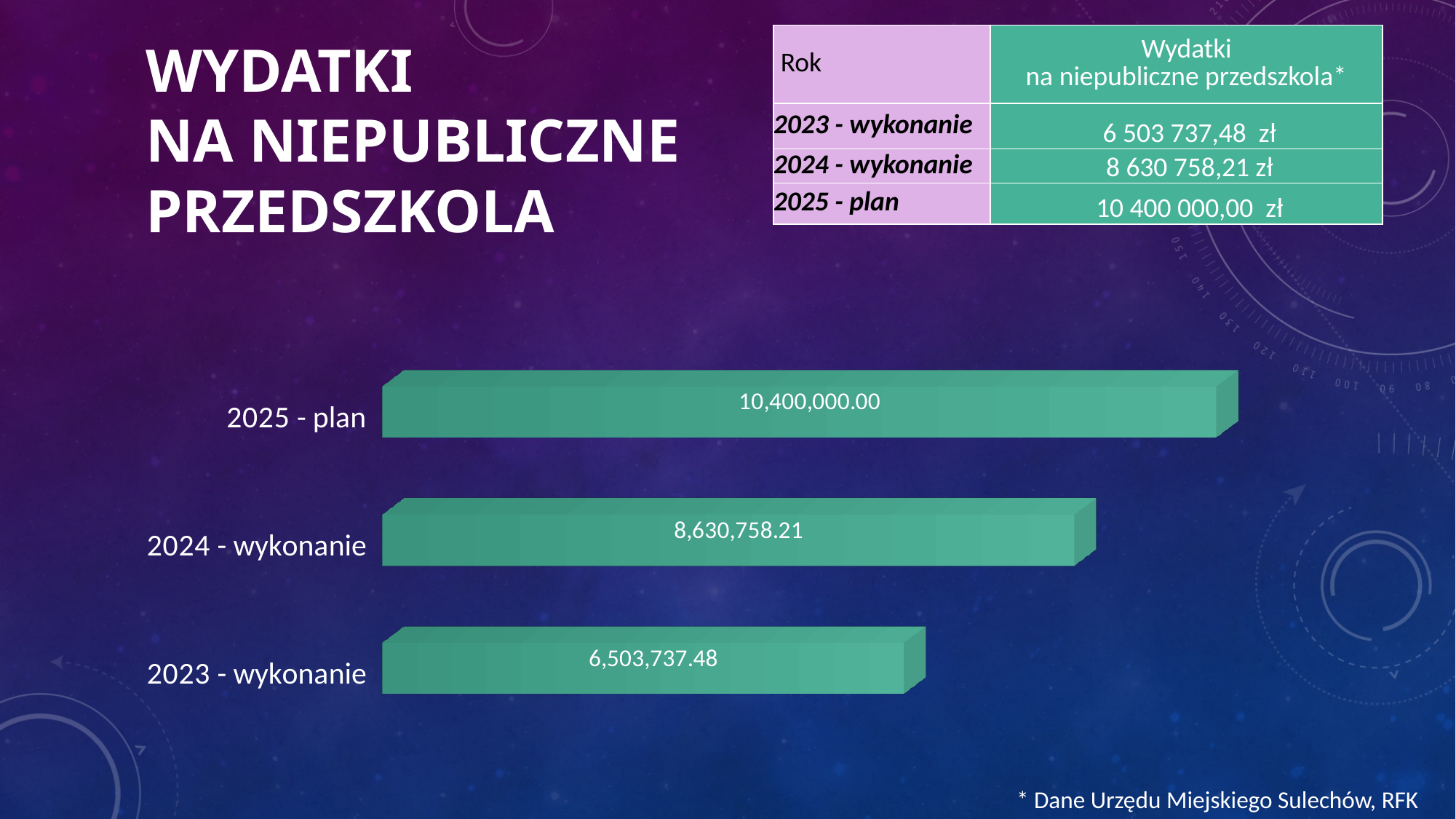
How many categories are shown in the chart? 3 What is the difference between the values for 2025 - plan and 2024 - wykonanie? 1,769,241.79 What is the value shown for 2025 - plan? 10,400,000.00 Which category has the lowest value? 2023 - wykonanie Which category has the highest value? 2025 - plan Which is larger, the value for 2024 - wykonanie or the value for 2023 - wykonanie? 2024 - wykonanie What is the value shown for 2024 - wykonanie? 8,630,758.21 What is the difference between the values for 2025 - plan and 2023 - wykonanie? 3,896,262.52 What is the value shown for 2023 - wykonanie? 6,503,737.48 Do the values rise or fall from 2023 - wykonanie to 2025 - plan? Rise What kind of chart is shown on the slide? Bar chart What is the difference between the values for 2024 - wykonanie and 2023 - wykonanie? 2,127,020.73